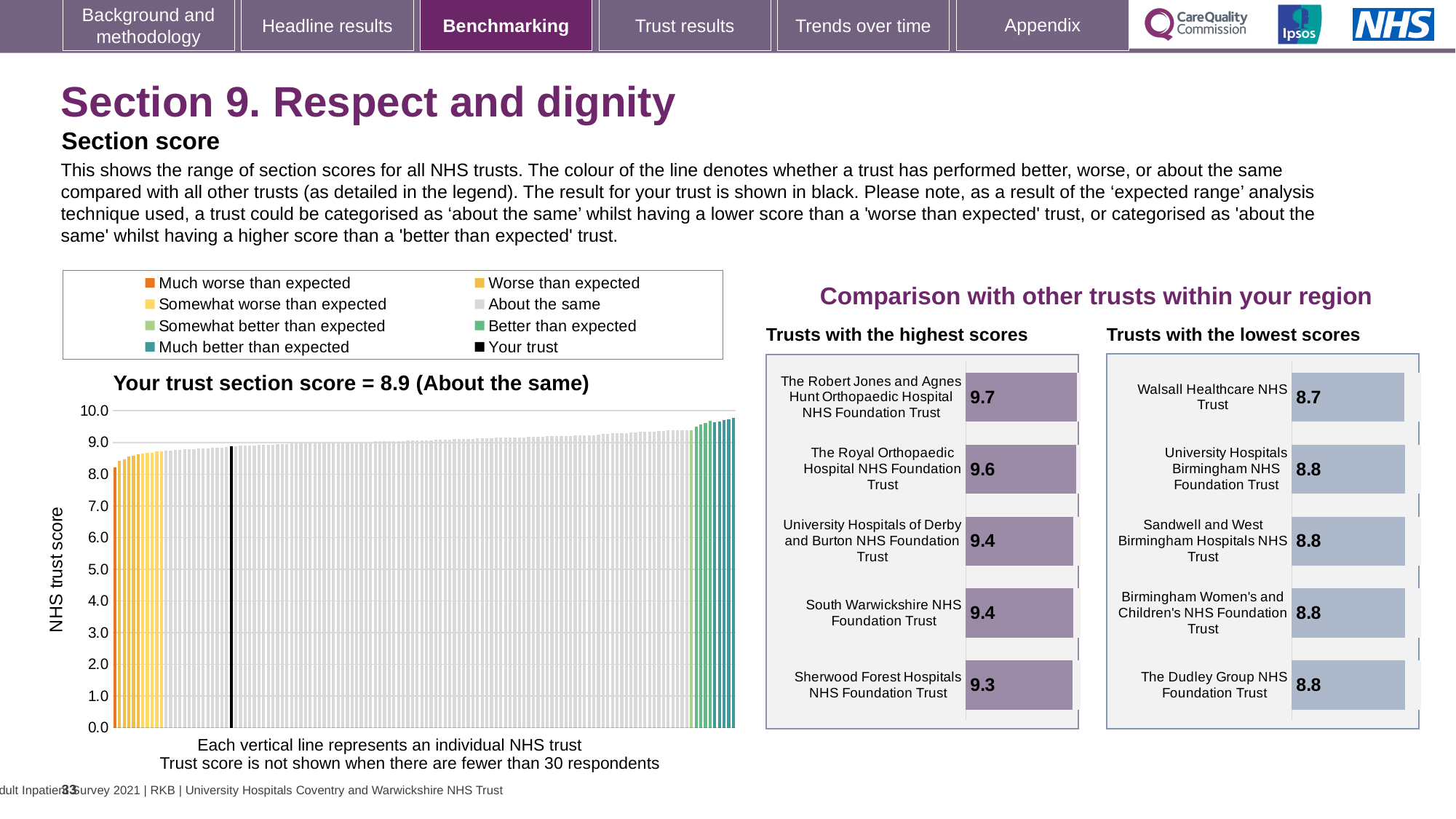
What is the y-axis label of the 'Your trust section score' chart? NHS trust score In the 'Trusts with the highest scores' chart, which trust has the highest score? The Robert Jones and Agnes Hunt Orthopaedic Hospital NHS Foundation Trust In the 'Trusts with the lowest scores' chart, which trust has the lowest score? Walsall Healthcare NHS Trust In the 'Trusts with the lowest scores' chart, which has the larger score: Walsall Healthcare NHS Trust or The Dudley Group NHS Foundation Trust? The Dudley Group NHS Foundation Trust In the 'Your trust section score' chart, what is the section score for your trust? 8.9 In the 'Your trust section score' chart, do the bars rise or fall from left to right? rise In the 'Trusts with the lowest scores' chart, what is the score for Walsall Healthcare NHS Trust? 8.7 What kind of chart is the 'Your trust section score' chart? bar chart In the 'Trusts with the highest scores' chart, what is the score for The Royal Orthopaedic Hospital NHS Foundation Trust? 9.6 How many trusts are shown in the 'Trusts with the highest scores' chart? 5 In the 'Trusts with the highest scores' chart, what is the difference between the scores of The Robert Jones and Agnes Hunt Orthopaedic Hospital NHS Foundation Trust and Sherwood Forest Hospitals NHS Foundation Trust? 0.4 How many entries does the legend above the 'Your trust section score' chart list? 8